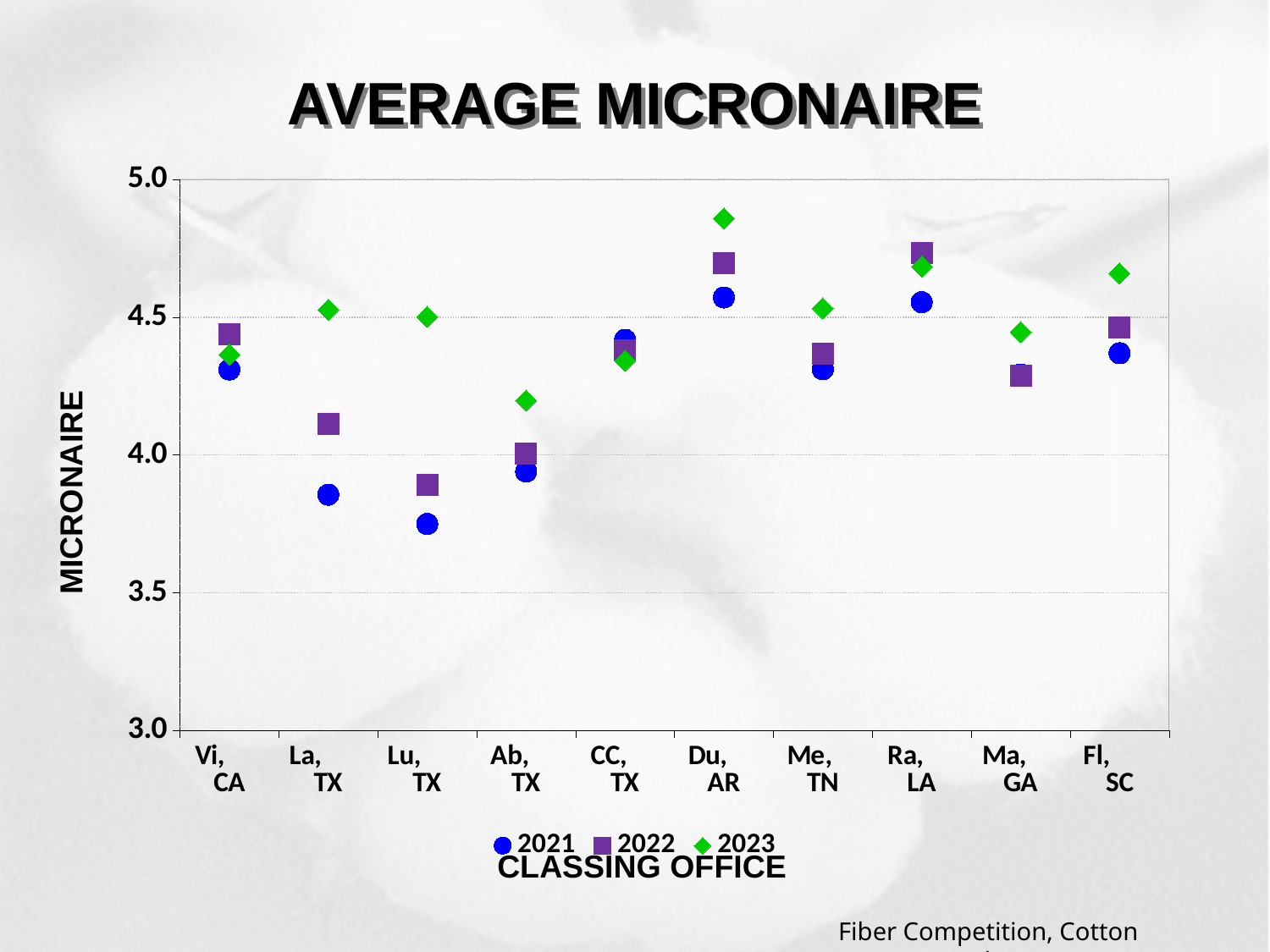
What is the title of the chart? AVERAGE MICRONAIRE Is the 2023 value for Fl, SC greater or less than 4.5? greater Is the 2022 value for Ma, GA greater or less than 4.5? less Is the 2021 value for Lu, TX greater or less than 4.0? less What kind of chart is shown on the slide? Scatter chart How many classing offices are shown on the x axis? 10 Which classing office has the lowest 2023 micronaire value? Ab, TX How many series does the legend list? 3 For Lu, TX, which is larger: the 2021 value or the 2022 value? 2022 Which classing office has the lowest 2021 micronaire value? Lu, TX Which classing office has the highest 2023 micronaire value? Du, AR